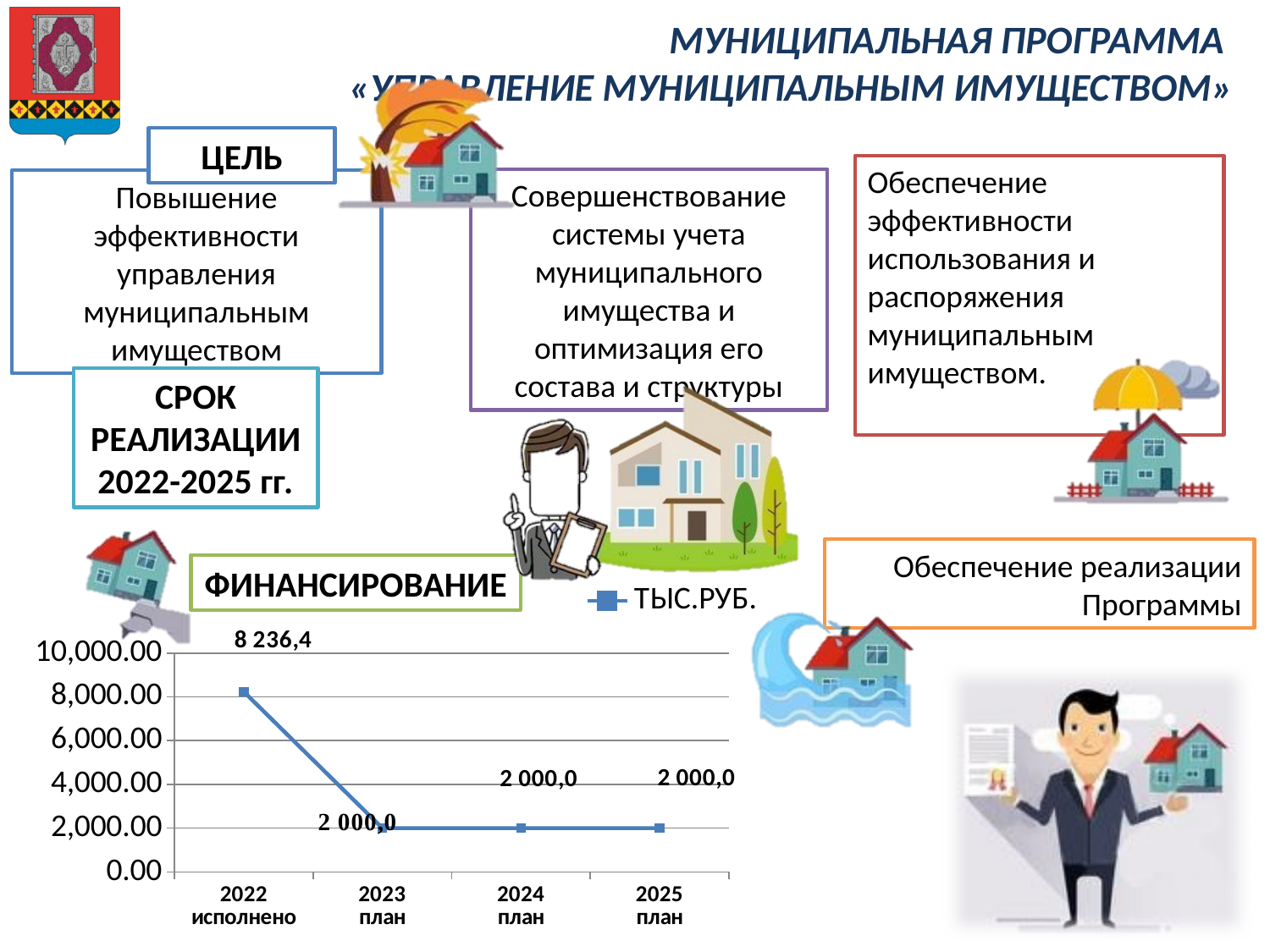
Is the value for 2022 исполнено greater or less than 6,000.00? greater Which is larger, the value for 2022 исполнено or the value for 2024 план? 2022 исполнено What is the difference between the values for 2022 исполнено and 2023 план? 6 236,4 How many categories are shown on the x axis? 4 What is the legend entry of the plotted series? ТЫС.РУБ. How many series does the legend list? 1 What type of chart is shown on the slide? line chart What is the value for 2023 план? 2 000,0 Is the value for 2024 план greater or less than 4,000.00? less Which category has the highest value? 2022 исполнено What is the value for 2025 план? 2 000,0 What is the value for 2022 исполнено? 8 236,4